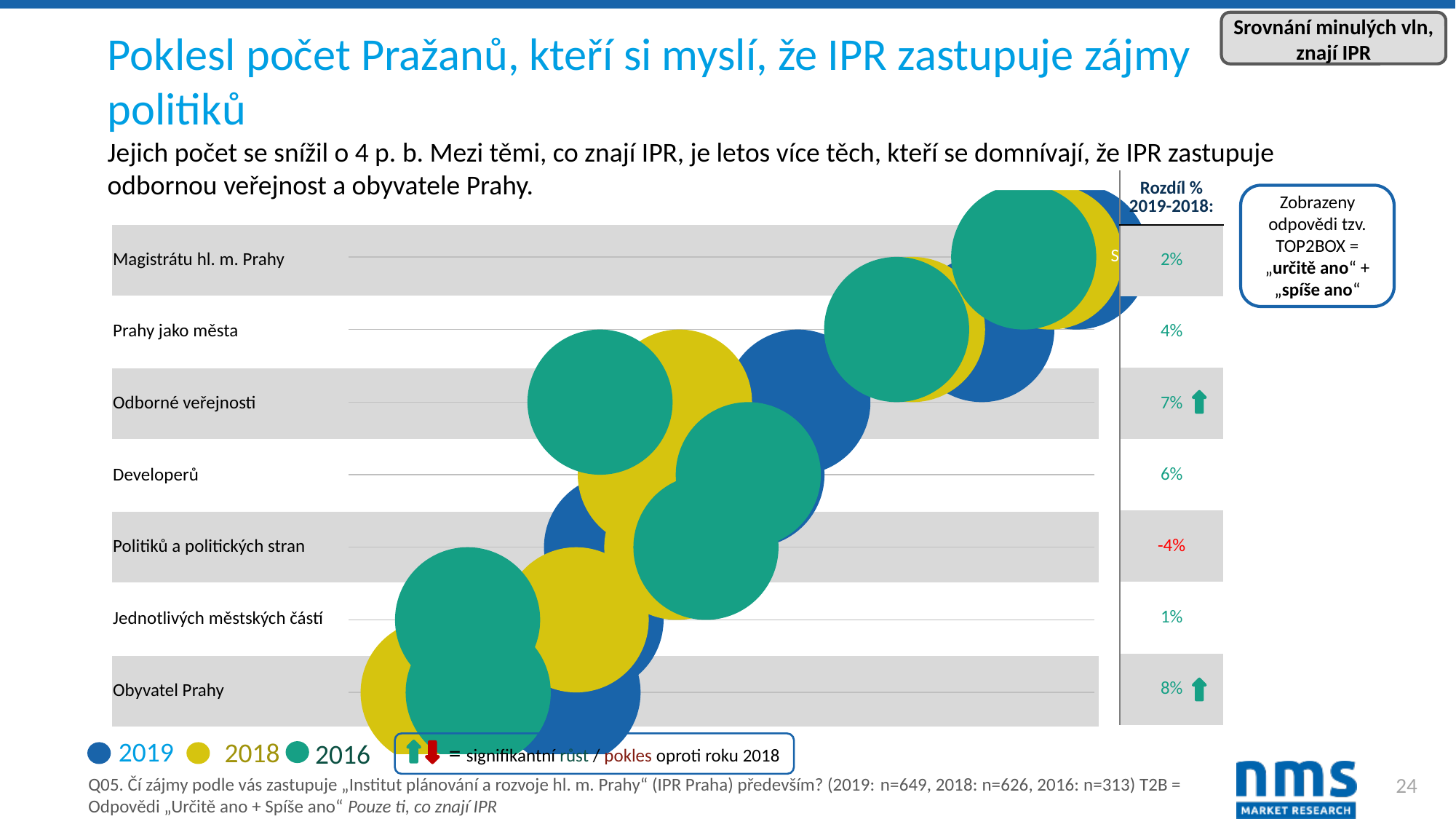
Which category has the lowest value in the "Rozdíl % 2019-2018" column? Politiků a politických stran What is the value in the "Rozdíl % 2019-2018" column for Odborné veřejnosti? 7% How many series (years) does the legend list? 3 What is the difference between the "Rozdíl % 2019-2018" values for Obyvatel Prahy and Magistrátu hl. m. Prahy? 6 percentage points How many categories are listed on the chart? 7 Which has a larger "Rozdíl % 2019-2018" value: Prahy jako města or Jednotlivých městských částí? Prahy jako města What is the value in the "Rozdíl % 2019-2018" column for Politiků a politických stran? -4% What is the value in the "Rozdíl % 2019-2018" column for Developerů? 6% Which category has the highest value in the "Rozdíl % 2019-2018" column? Obyvatel Prahy Which year is shown in blue in the legend? 2019 What is the value in the "Rozdíl % 2019-2018" column for Obyvatel Prahy? 8% What is the value in the "Rozdíl % 2019-2018" column for Magistrátu hl. m. Prahy? 2%